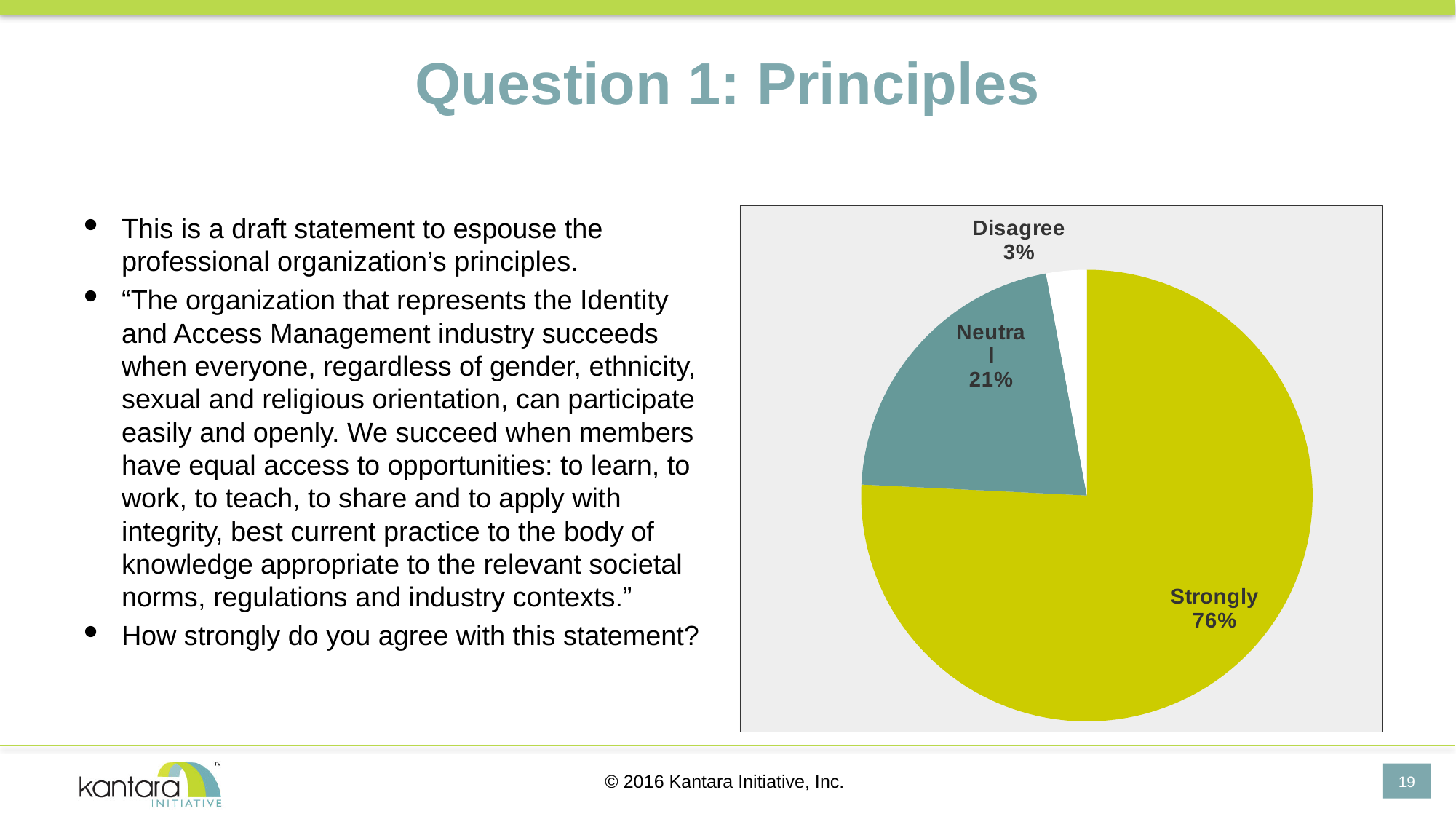
Which is larger, the Neutral slice or the Disagree slice? Neutral What colour is the Strongly slice of the pie chart? yellow-green What kind of chart is shown on the slide? pie chart What is the difference in percentage points between the Strongly and Neutral slices? 55 What share of the pie is labelled Neutral? 21% What colour is the Neutral slice of the pie chart? teal What share of the pie is labelled Strongly? 76% How many slices does the pie chart have? 3 Which slice of the pie chart is the largest? Strongly What share of the pie is labelled Disagree? 3% Which slice of the pie chart is the smallest? Disagree What is the difference in percentage points between the Neutral and Disagree slices? 18